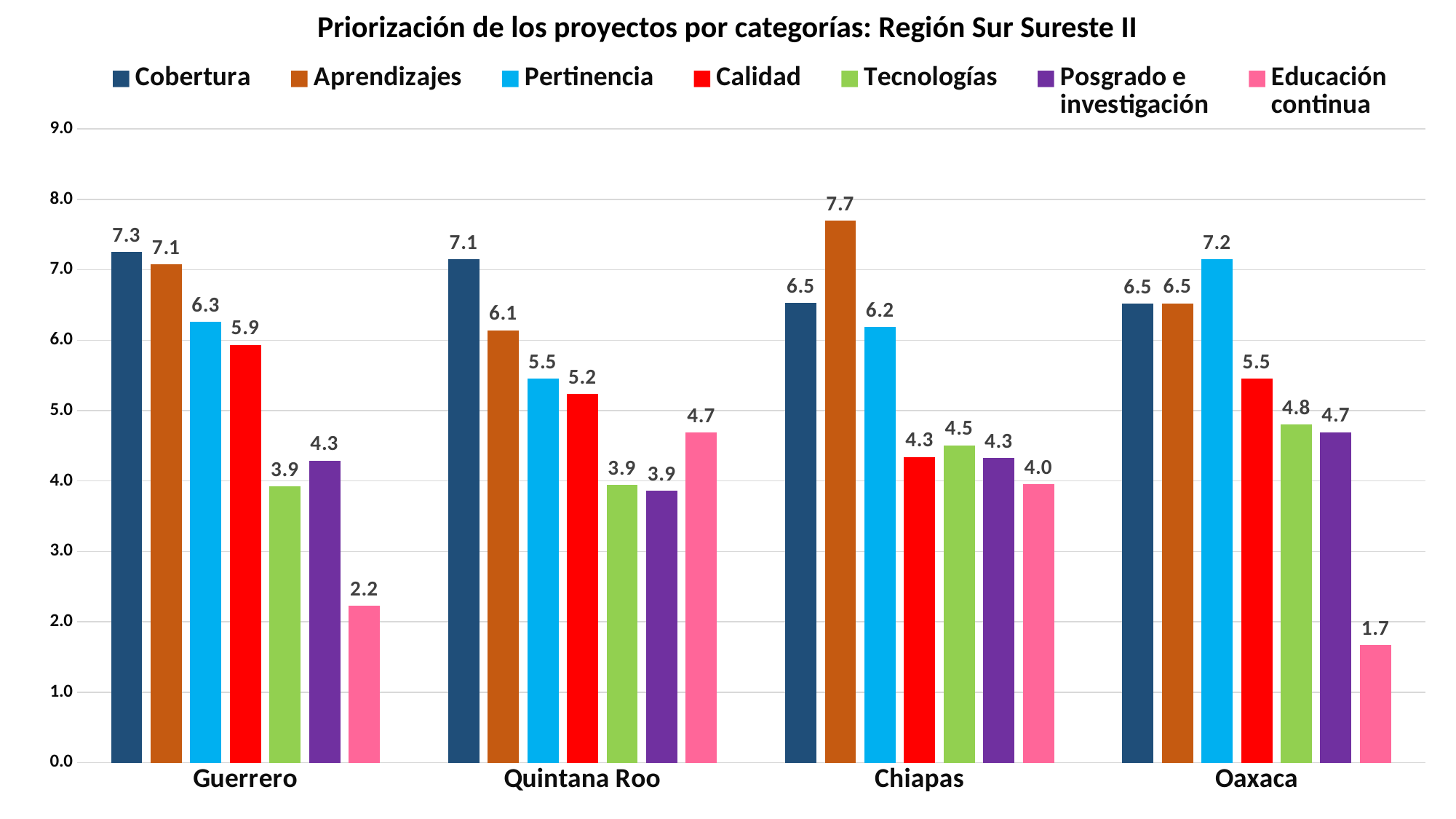
Which is larger, Tecnologías in Chiapas or Tecnologías in Oaxaca? Tecnologías in Oaxaca What kind of chart is this? Bar chart How many series does the legend list? 7 What is the value for Educación continua in Oaxaca? 1.7 Which series has the lowest value in Guerrero? Educación continua Which series has the highest value in Oaxaca? Pertinencia What is the title of the chart? Priorización de los proyectos por categorías: Región Sur Sureste II What is the difference between Cobertura and Calidad in Quintana Roo? 1.9 What is the value for Pertinencia in Quintana Roo? 5.5 How many states are shown on the x axis? 4 What is the value for Aprendizajes in Chiapas? 7.7 What is the value for Cobertura in Guerrero? 7.3